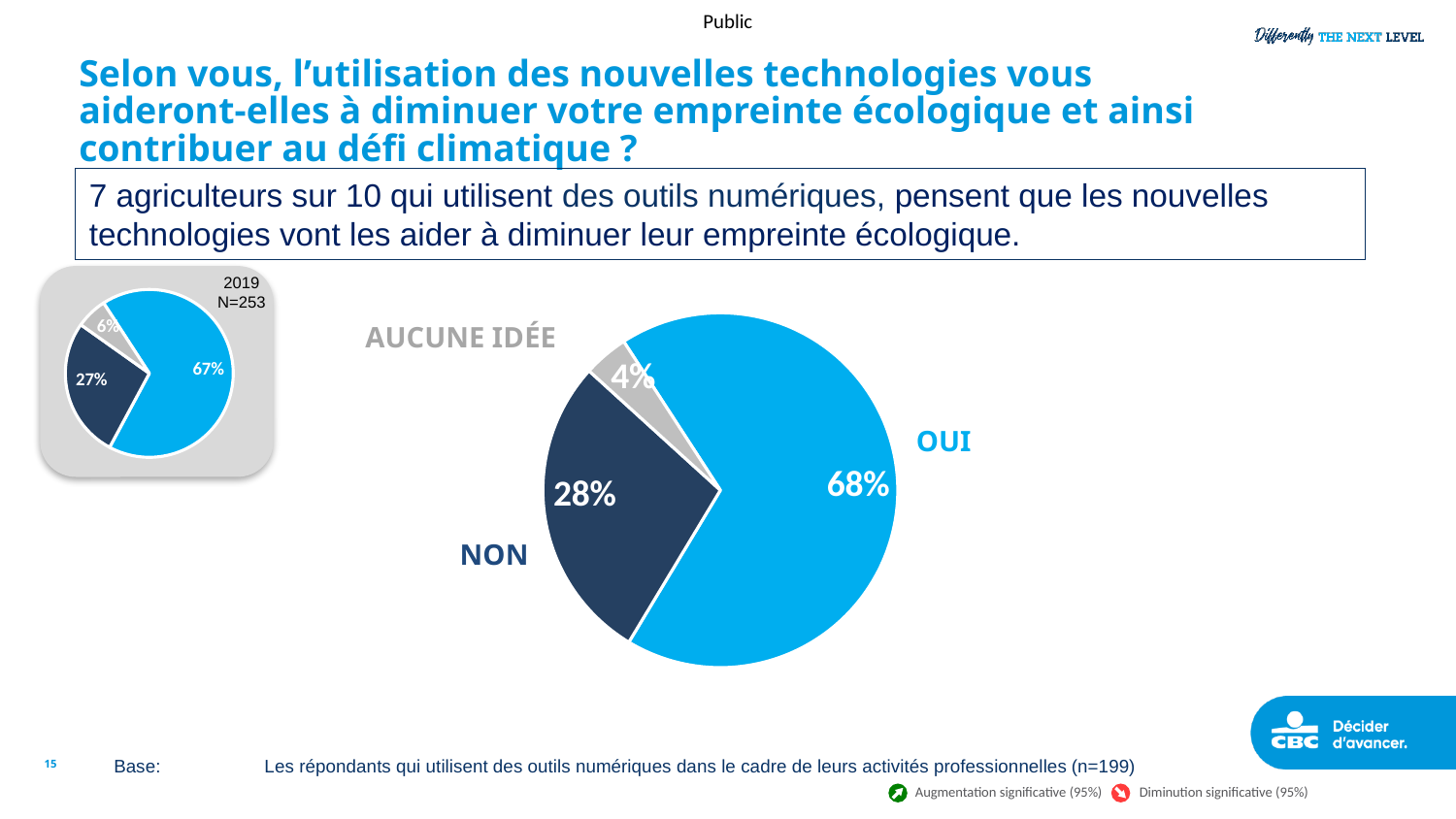
What sample size (N) is shown next to the small 2019 pie chart on the left of the slide? N=253 In the large pie chart in the centre of the slide, which category has the largest slice? OUI In the large pie chart in the centre of the slide, what percentage is shown for OUI? 68% In the large pie chart in the centre of the slide, what colour is the OUI slice? Light blue In the large pie chart in the centre of the slide, which category has the smallest slice? AUCUNE IDÉE In the large pie chart in the centre of the slide, what is the difference in percentage points between OUI and NON? 40 How many slices does the large pie chart in the centre of the slide have? 3 In the large pie chart in the centre of the slide, what percentage is shown for AUCUNE IDÉE? 4% In the small pie chart on the left of the slide labelled 2019, what is the largest percentage shown? 67% What type of chart is the large chart in the centre of the slide? Pie chart In the large pie chart in the centre of the slide, which is larger, NON or AUCUNE IDÉE? NON In the large pie chart in the centre of the slide, what percentage is shown for NON? 28%